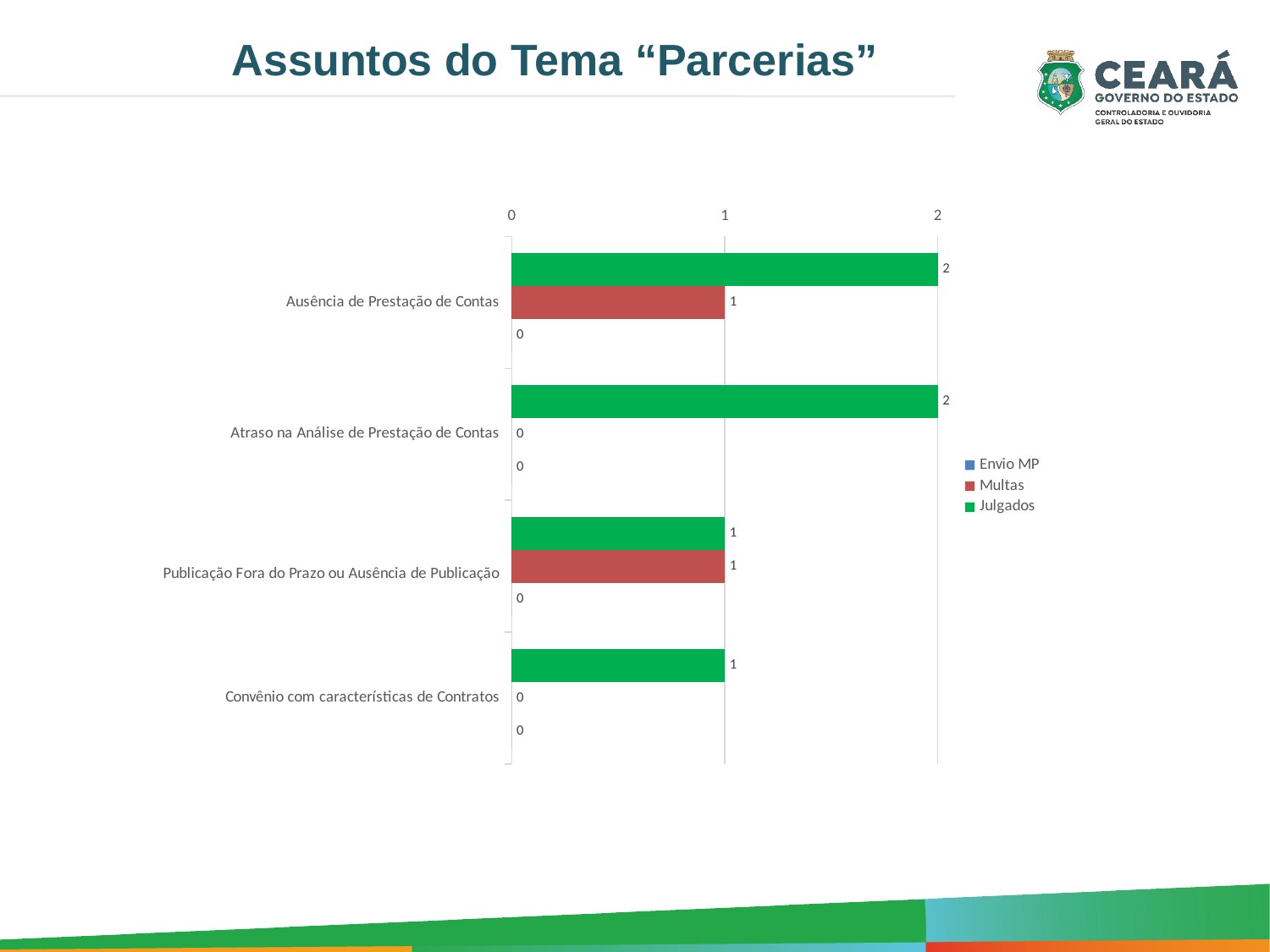
What is the Multas value for Ausência de Prestação de Contas? 1 How many series does the legend list? 3 What is the Julgados value for Ausência de Prestação de Contas? 2 How many categories are shown on the chart? 4 What is the title of the slide containing the chart? Assuntos do Tema "Parcerias" What is the Multas value for Convênio com características de Contratos? 0 What is the difference between the Julgados values for Atraso na Análise de Prestação de Contas and Convênio com características de Contratos? 1 What is the Envio MP value for Atraso na Análise de Prestação de Contas? 0 Which is larger for Ausência de Prestação de Contas: Julgados or Multas? Julgados Which series is shown in green in the legend? Julgados What type of chart is shown on the slide? bar chart What is the Julgados value for Publicação Fora do Prazo ou Ausência de Publicação? 1